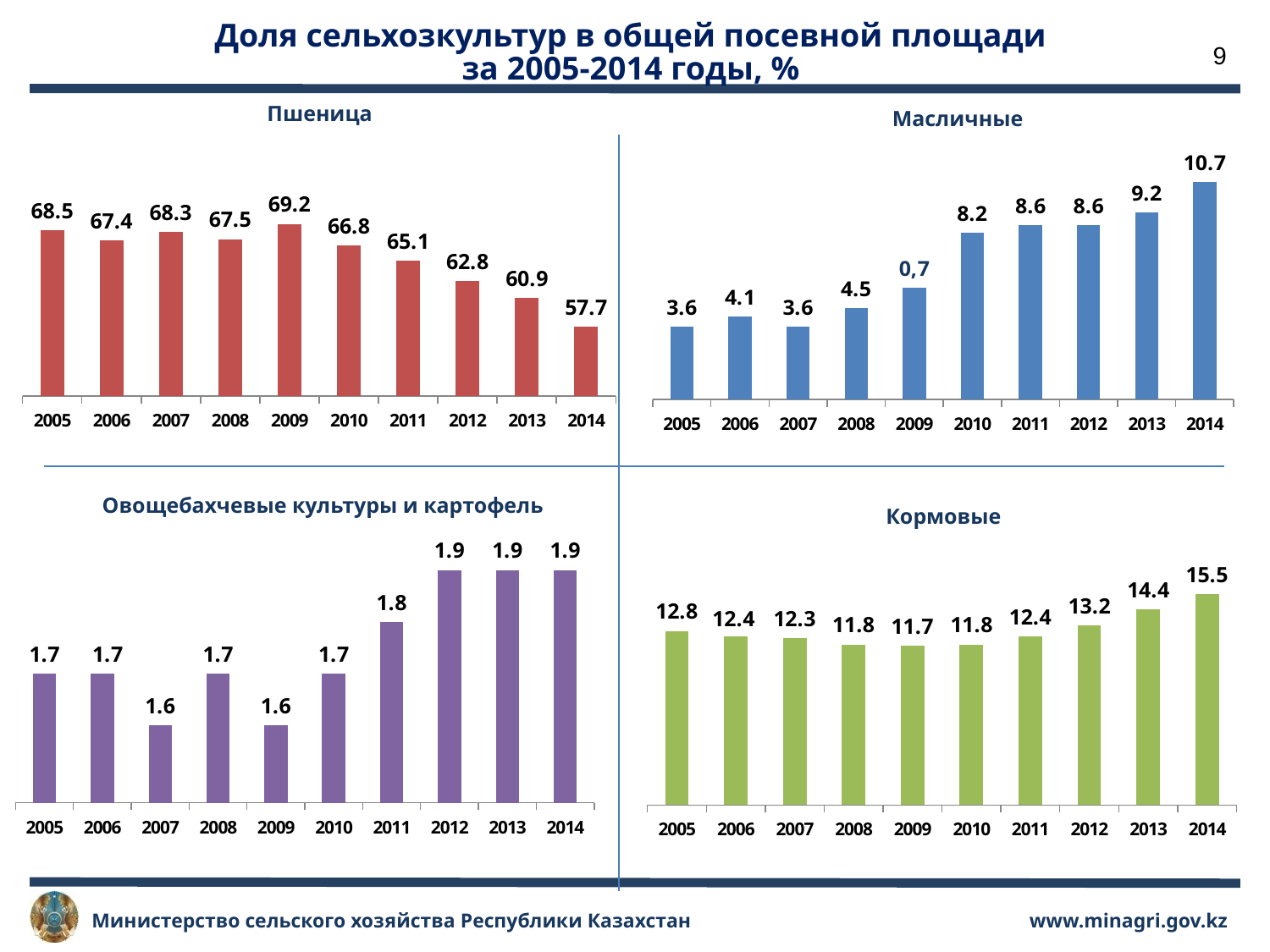
In the Масличные chart, what is the value for 2014? 10.7 In the Пшеница chart, what is the difference between the values for 2009 and 2014? 11.5 In the Кормовые chart, what is the value for 2009? 11.7 In the Пшеница chart, which year has the lowest value? 2014 In the Пшеница chart, what is the value for 2005? 68.5 In the Кормовые chart, do the values rise or fall from 2011 to 2014? rise In the Овощебахчевые культуры и картофель chart, what is the value for 2011? 1.8 In the Масличные chart, is the value for 2010 larger than the value for 2008? Yes In the Овощебахчевые культуры и картофель chart, how many years are shown on the x axis? 10 In the Масличные chart, which year has the highest value? 2014 What kind of chart is the Пшеница chart? bar chart In the Кормовые chart, what is the difference between the values for 2014 and 2005? 2.7